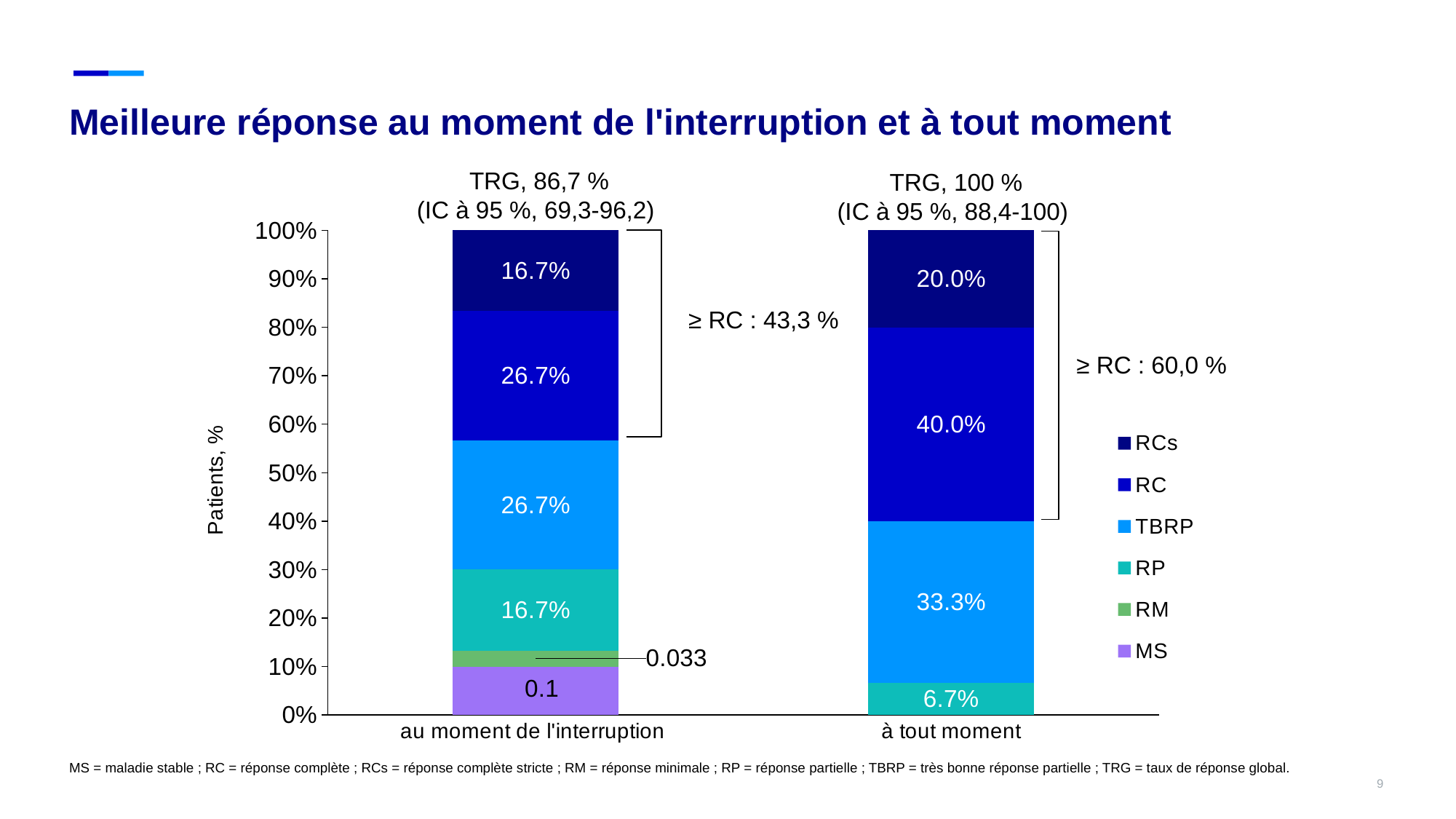
What kind of chart is shown on the slide? stacked bar chart Which category has the larger RC value, 'au moment de l'interruption' or 'à tout moment'? à tout moment What is the RC value for 'à tout moment'? 40.0% What is the RP value for 'à tout moment'? 6.7% What is the difference between the RCs values for 'à tout moment' and 'au moment de l'interruption'? 3.3% What is the RCs value for 'au moment de l'interruption'? 16.7% What is the data label shown for the RM segment of 'au moment de l'interruption'? 0.033 What is the TRG (overall response rate) shown above the 'à tout moment' bar? 100 % How many categories are shown on the x axis? 2 How many series does the legend list? 6 What is the data label shown for the MS segment of 'au moment de l'interruption'? 0.1 What is the TBRP value for 'à tout moment'? 33.3%